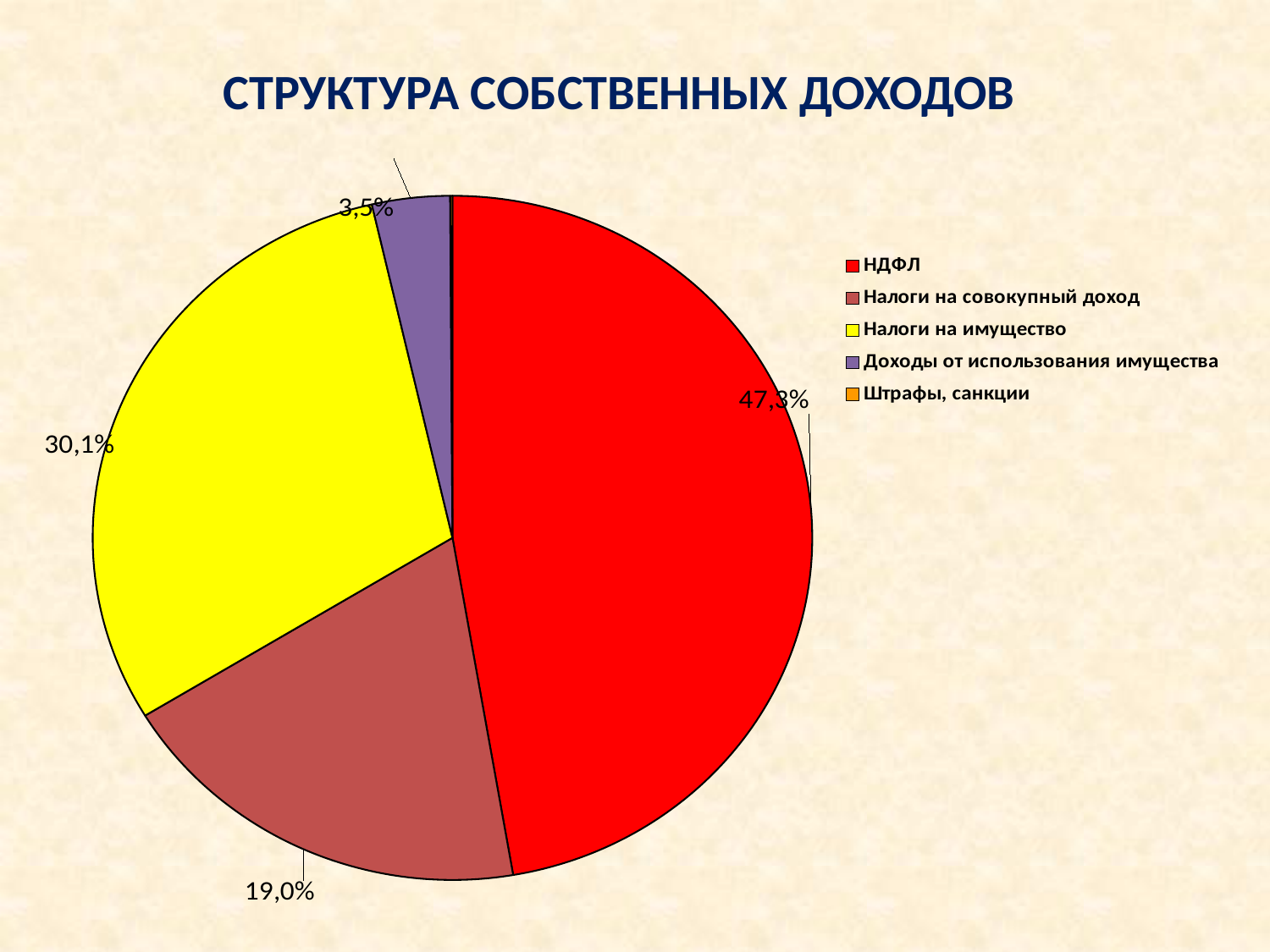
What type of chart is shown on the slide? Pie chart Which category has the smallest printed share on the chart? Доходы от использования имущества What share of the pie does НДФЛ account for? 47,3% What colour is the НДФЛ slice? Red What is the value shown for Налоги на совокупный доход? 19,0% What is the value shown for Доходы от использования имущества? 3,5% How many categories does the legend list? 5 Which is larger: the share of Налоги на имущество or the share of Налоги на совокупный доход? Налоги на имущество What is the title of the chart? СТРУКТУРА СОБСТВЕННЫХ ДОХОДОВ What is the difference between the shares of НДФЛ and Налоги на имущество? 17,2% What is the value shown for Налоги на имущество? 30,1% Which category has the largest slice of the pie? НДФЛ